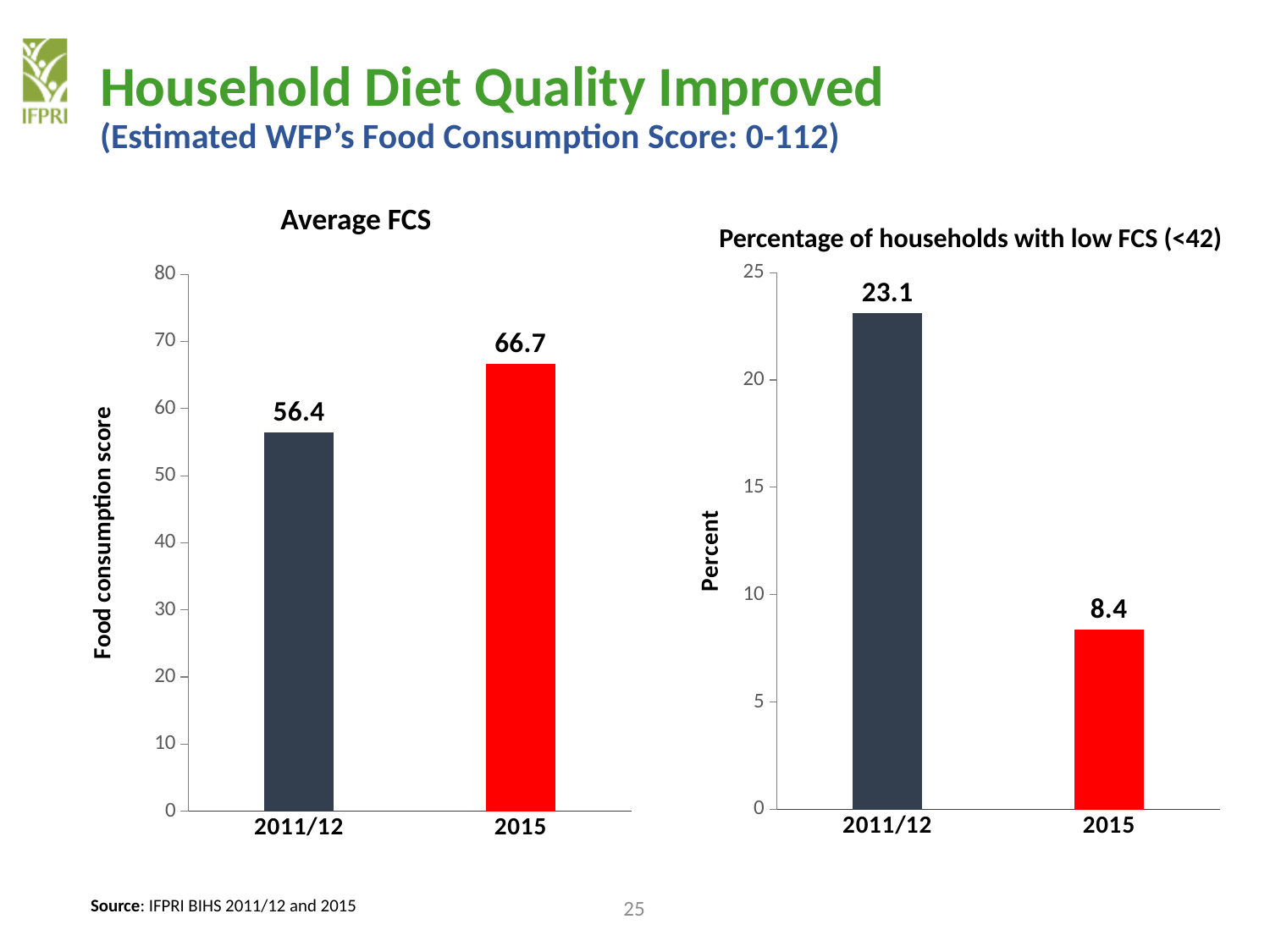
In the 'Percentage of households with low FCS (<42)' chart, is the value for 2011/12 greater or less than 20? greater In the 'Average FCS' chart, what is the difference between the 2015 and 2011/12 values? 10.3 What is the y-axis label of the 'Percentage of households with low FCS (<42)' chart? Percent In the 'Percentage of households with low FCS (<42)' chart, what is the value for 2011/12? 23.1 In the 'Percentage of households with low FCS (<42)' chart, which year has the lowest value? 2015 In the 'Average FCS' chart, which year has the higher value? 2015 In the 'Average FCS' chart, do the values rise or fall from 2011/12 to 2015? rise What kind of chart is the 'Average FCS' chart? bar chart In the 'Average FCS' chart, what is the value for 2015? 66.7 In the 'Average FCS' chart, what is the value for 2011/12? 56.4 In the 'Percentage of households with low FCS (<42)' chart, what is the difference between the 2011/12 and 2015 values? 14.7 In the 'Percentage of households with low FCS (<42)' chart, what is the value for 2015? 8.4